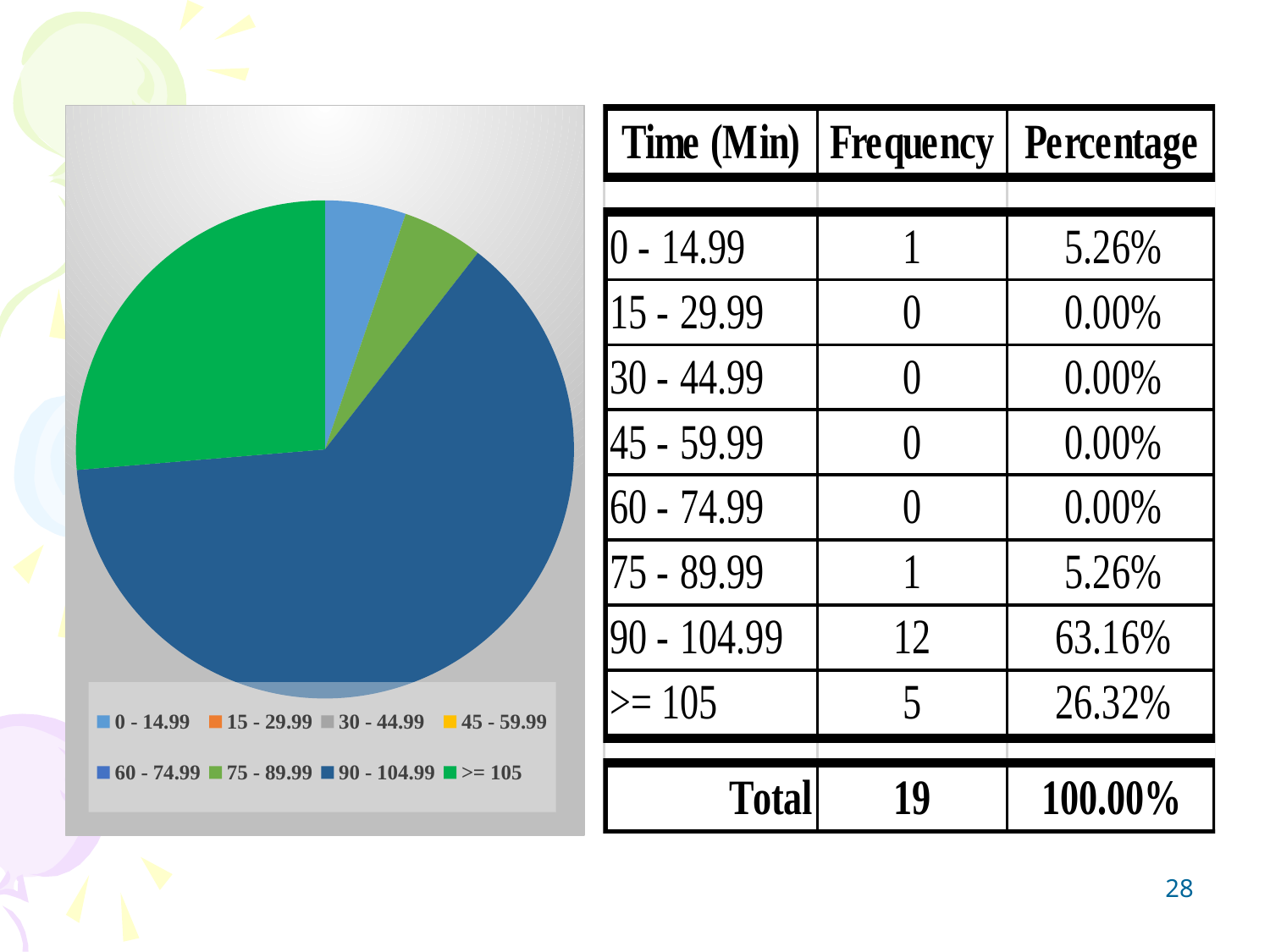
According to the table, what percentage does the >= 105 category account for? 26.32% What colour is the slice for the 90 - 104.99 category in the pie chart? dark blue What is the total frequency shown in the table? 19 Which time category has the largest slice of the pie chart? 90 - 104.99 What is the difference in frequency between the 90 - 104.99 category and the >= 105 category? 7 According to the table, what is the frequency for the >= 105 category? 5 According to the table, what percentage does the 0 - 14.99 category account for? 5.26% According to the table, what is the frequency for the 90 - 104.99 category? 12 What kind of chart is shown on the left of the slide? pie chart How many categories does the pie chart's legend list? 8 How many time categories in the table have a frequency of 0? 4 Which is larger in the pie chart, the slice for >= 105 or the slice for 75 - 89.99? >= 105